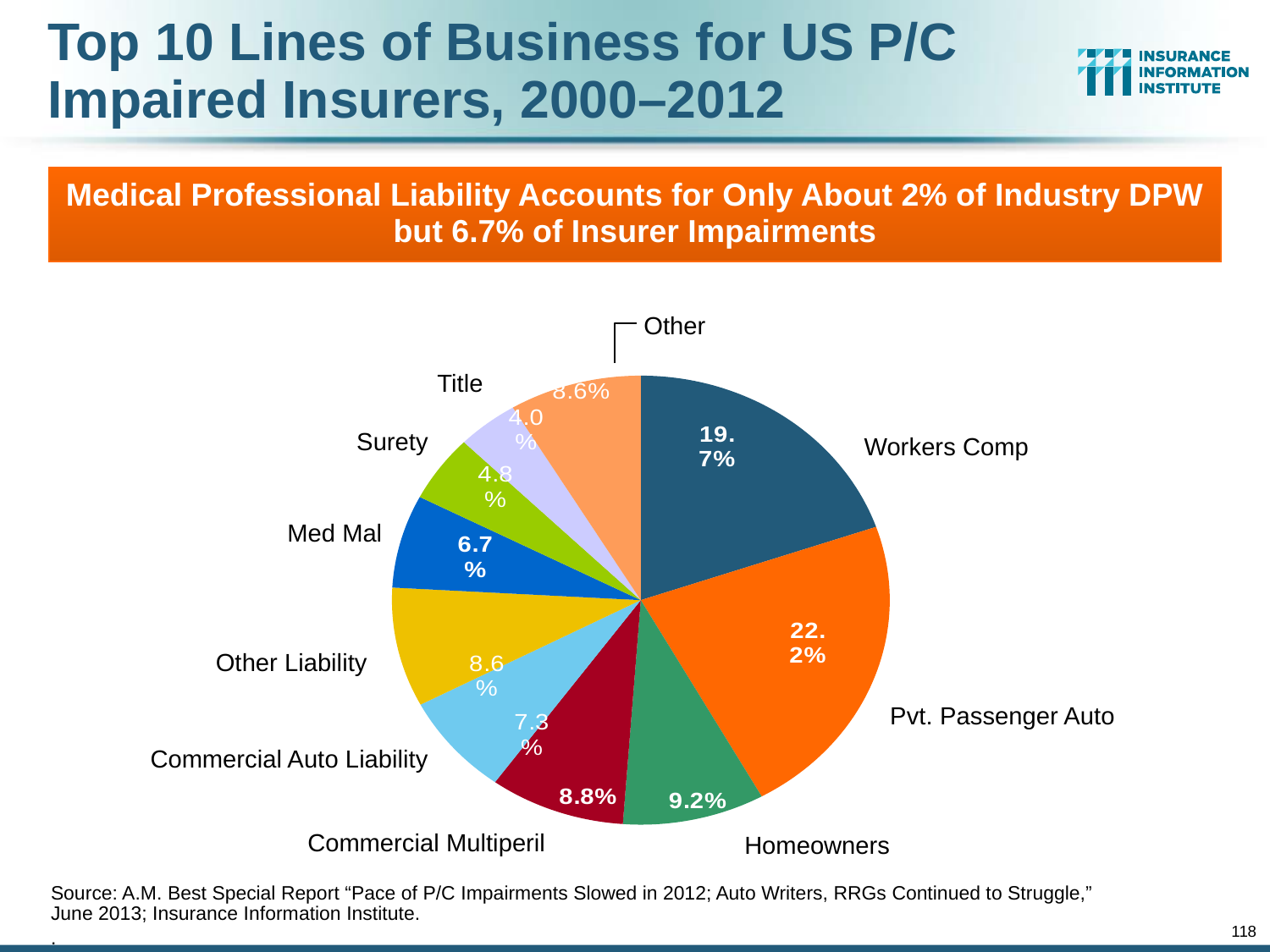
What is the value shown for Workers Comp? 19.7% Which line of business has the smallest slice of the pie? Title What is the combined share of Surety and Title? 8.8% What is the difference between the Pvt. Passenger Auto and Workers Comp shares? 2.5% How many slices does the pie chart have? 10 What is the value for Homeowners? 9.2% What percentage is shown for Med Mal? 6.7% What share of impairments does Pvt. Passenger Auto account for? 22.2% Which line of business has the largest slice of the pie? Pvt. Passenger Auto What kind of chart is shown on the slide? pie chart What is the value for Commercial Auto Liability? 7.3% Which is larger, the share for Homeowners or the share for Commercial Multiperil? Homeowners